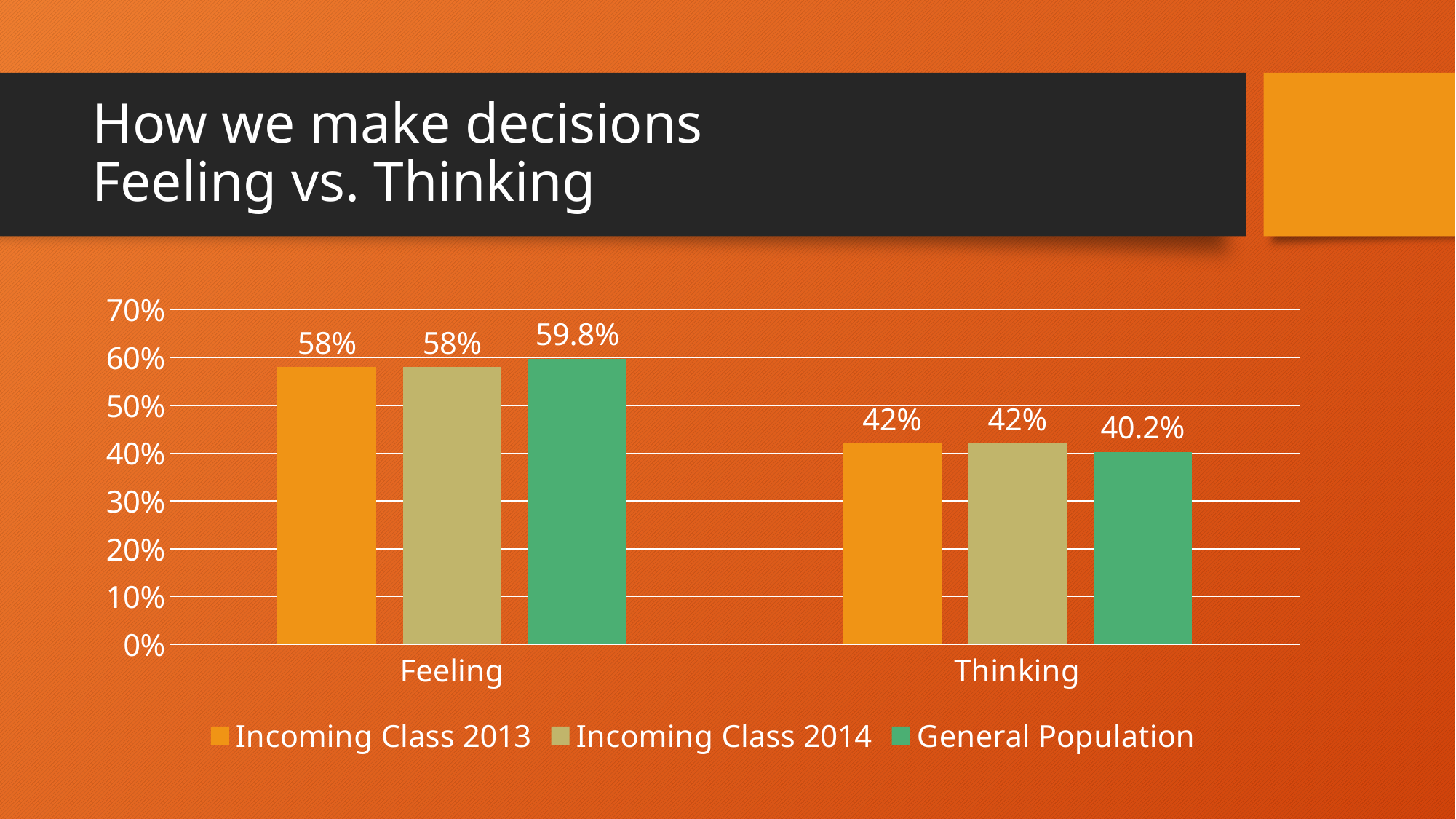
How many series does the legend list? 3 Which is larger: the Incoming Class 2013 value for Feeling or for Thinking? Feeling How many categories are shown on the x axis? 2 What kind of chart is shown on the slide? Bar chart Which series has the highest value in the Feeling category? General Population What is the value for General Population in the Feeling category? 59.8% Which colour represents General Population in the legend? Green What is the difference between the General Population values for Feeling and Thinking? 19.6% What is the value for General Population in the Thinking category? 40.2% What is the value for Incoming Class 2014 in the Thinking category? 42% Which series has the lowest value in the Thinking category? General Population What is the value for Incoming Class 2013 in the Feeling category? 58%